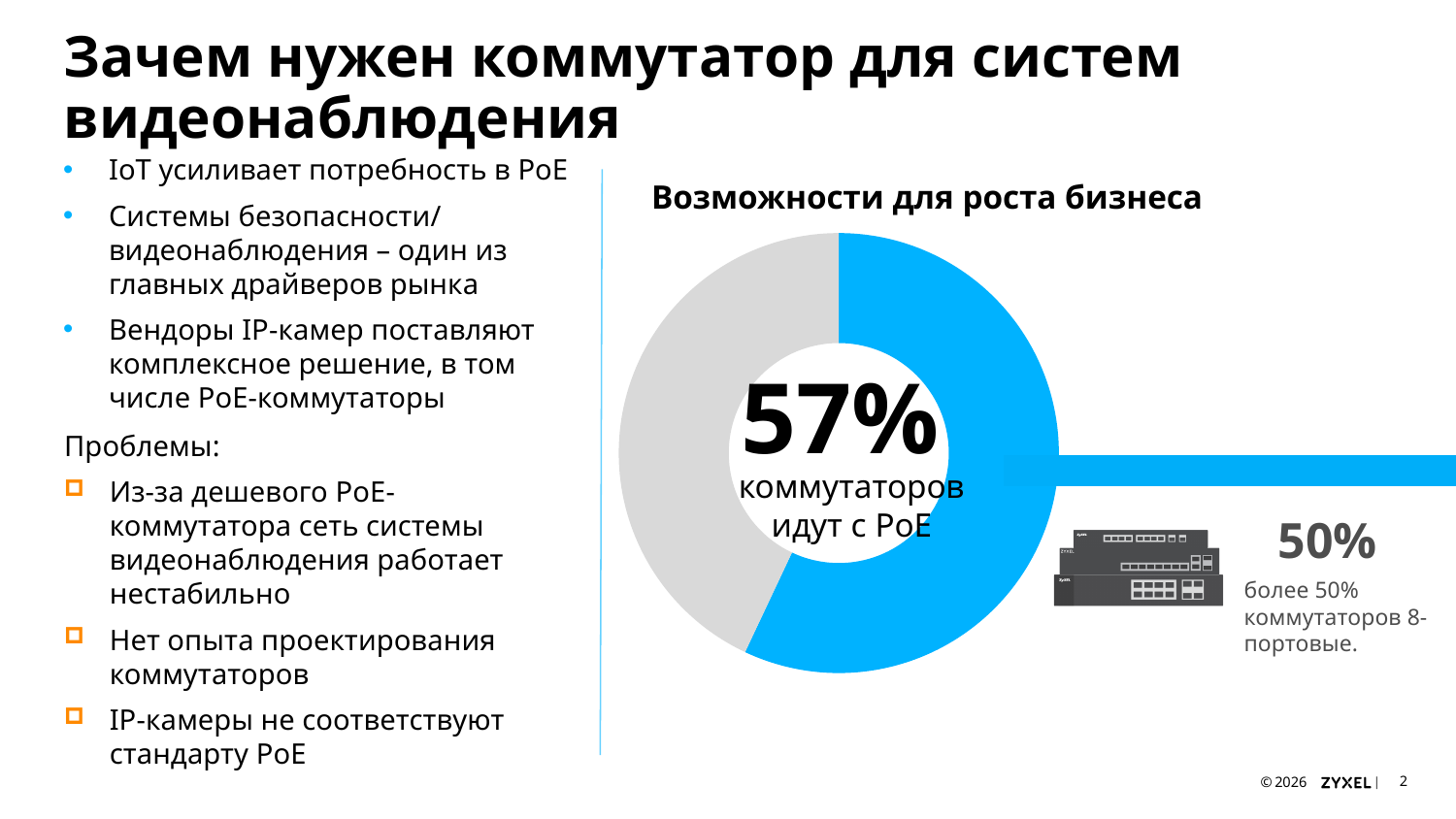
What value is printed in the centre of the donut chart? 57% How many slices does the donut chart have? 2 Is the share of switches that come with PoE greater or less than 50%? greater What colour is the slice representing switches that come with PoE? Blue What percentage of switches come with PoE according to the chart? 57% What is the title above the donut chart? Возможности для роста бизнеса Which slice of the donut chart is larger, the blue one or the grey one? The blue one What does the 57% slice of the chart represent, according to the label in the centre? коммутаторов идут с PoE What kind of chart is shown on the slide? Pie chart (donut) What share of the donut chart does the blue slice represent? 57%